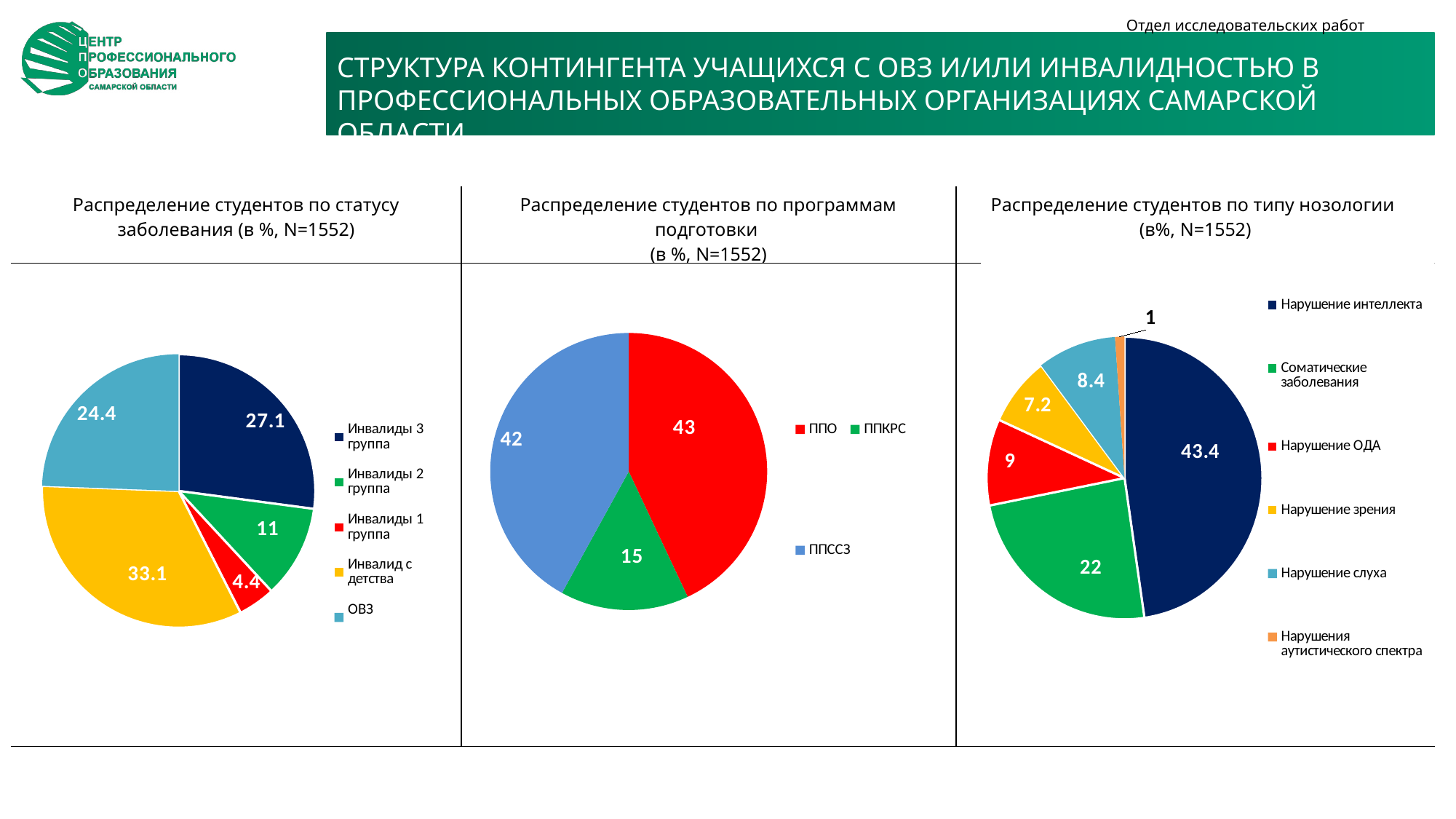
In the right chart (Распределение студентов по типу нозологии), how many categories does the legend list? 6 In the right chart (Распределение студентов по типу нозологии), which is larger: Нарушение ОДА or Нарушение зрения? Нарушение ОДА In the middle chart (Распределение студентов по программам подготовки), which program has the largest share? ППО In the middle chart (Распределение студентов по программам подготовки), what is the value for ППКРС? 15 In the right chart (Распределение студентов по типу нозологии), which category has the largest share? Нарушение интеллекта In the right chart (Распределение студентов по типу нозологии), what is the value for Нарушение слуха? 8.4 In the left chart (Распределение студентов по статусу заболевания), how many categories does the pie have? 5 In the left chart (Распределение студентов по статусу заболевания), which category has the smallest share? Инвалиды 1 группа In the left chart (Распределение студентов по статусу заболевания), what is the difference between Инвалиды 3 группа and ОВЗ? 2.7 In the middle chart (Распределение студентов по программам подготовки), what kind of chart is shown? Pie chart In the left chart (Распределение студентов по статусу заболевания), what is the value for Инвалид с детства? 33.1 In the right chart (Распределение студентов по типу нозологии), what is the difference between Соматические заболевания and Нарушение ОДА? 13